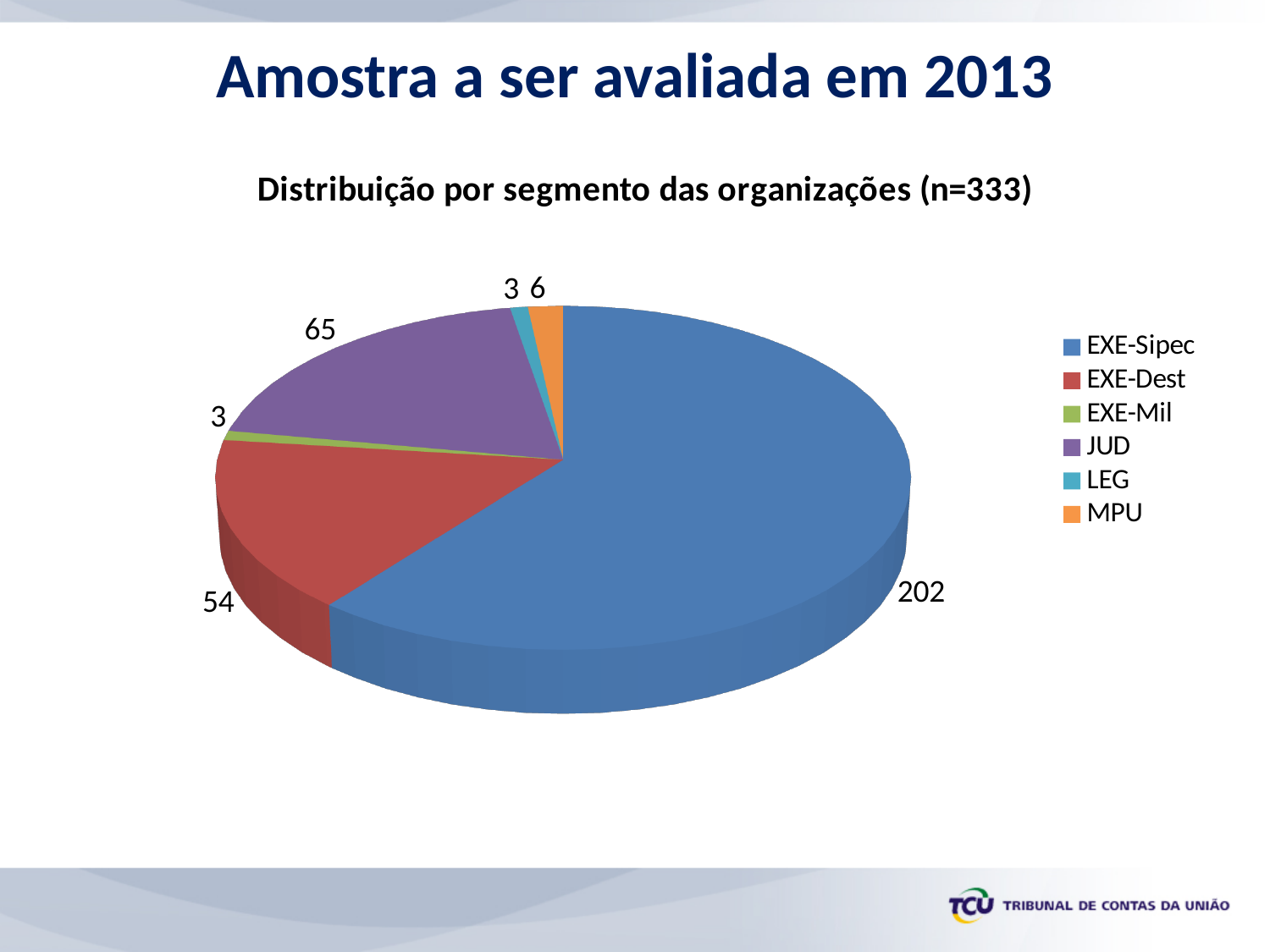
What is the difference between the values for JUD and EXE-Dest? 11 What is the value for MPU in the pie chart? 6 What is the value for EXE-Dest in the pie chart? 54 What is the value for EXE-Mil in the pie chart? 3 What is the value for JUD in the pie chart? 65 Which is larger, the value for EXE-Dest or the value for JUD? JUD What is the title of the chart on the slide? Distribuição por segmento das organizações (n=333) What is the value for EXE-Sipec in the pie chart? 202 What kind of chart is shown on the slide? Pie chart Which segment has the largest slice of the pie chart? EXE-Sipec What is the difference between the values for EXE-Sipec and JUD? 137 How many segments does the legend of the pie chart list? 6